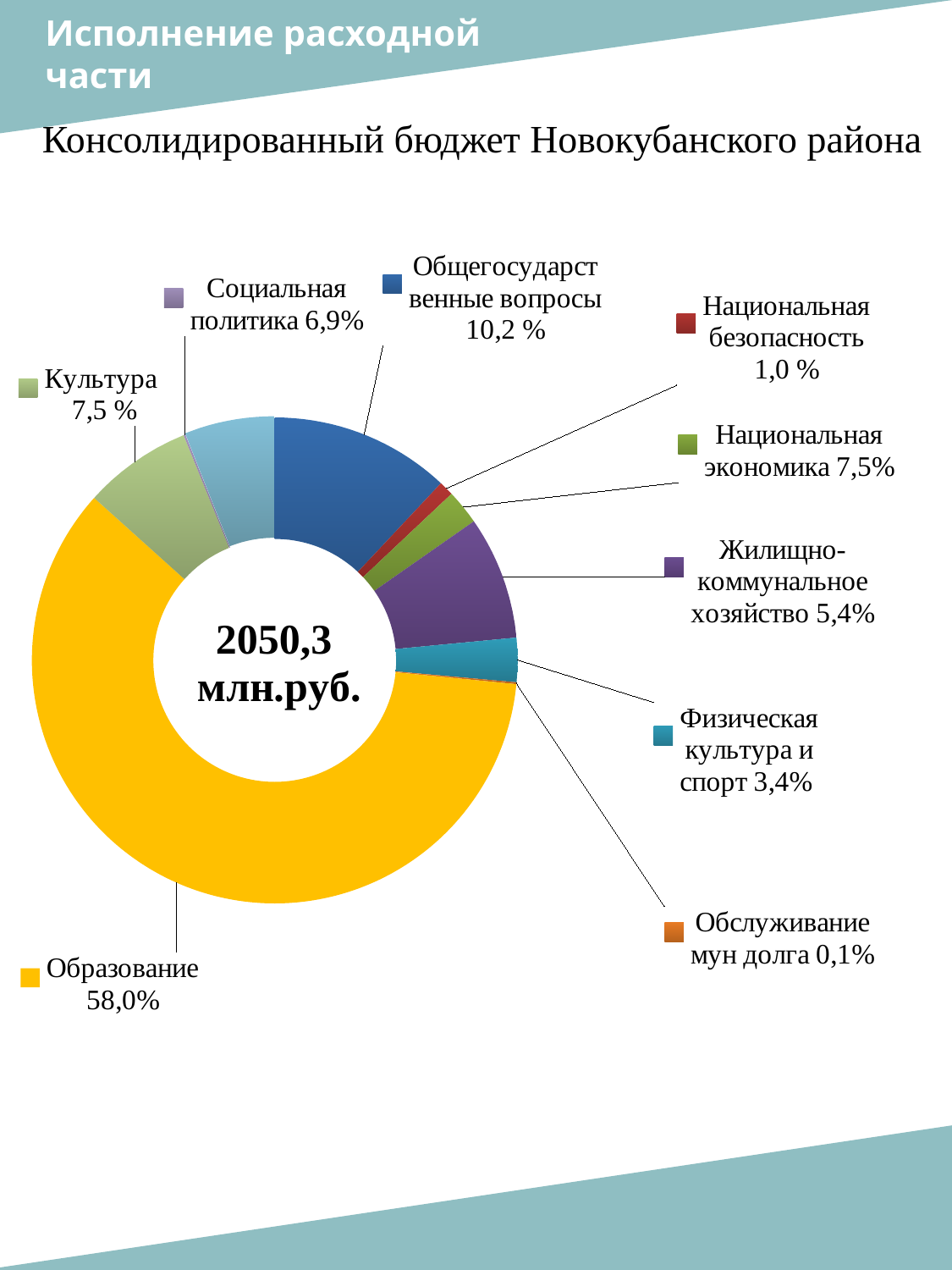
How many categories are shown in the chart? 9 Which category has the largest share of the chart? Образование What share is shown for Физическая культура и спорт? 3,4% What share is shown for Общегосударственные вопросы? 10,2 % What share of the chart does Образование account for? 58,0% What kind of chart is shown on the slide? Doughnut (pie) chart What total value is printed in the centre of the chart? 2050,3 млн.руб. Which has the larger share, Национальная безопасность or Физическая культура и спорт? Физическая культура и спорт Which category has the smallest share of the chart? Обслуживание мун долга What is the title printed above the chart? Консолидированный бюджет Новокубанского района What share is shown for Жилищно-коммунальное хозяйство? 5,4% What is the difference in percentage points between Общегосударственные вопросы and Социальная политика? 3,3